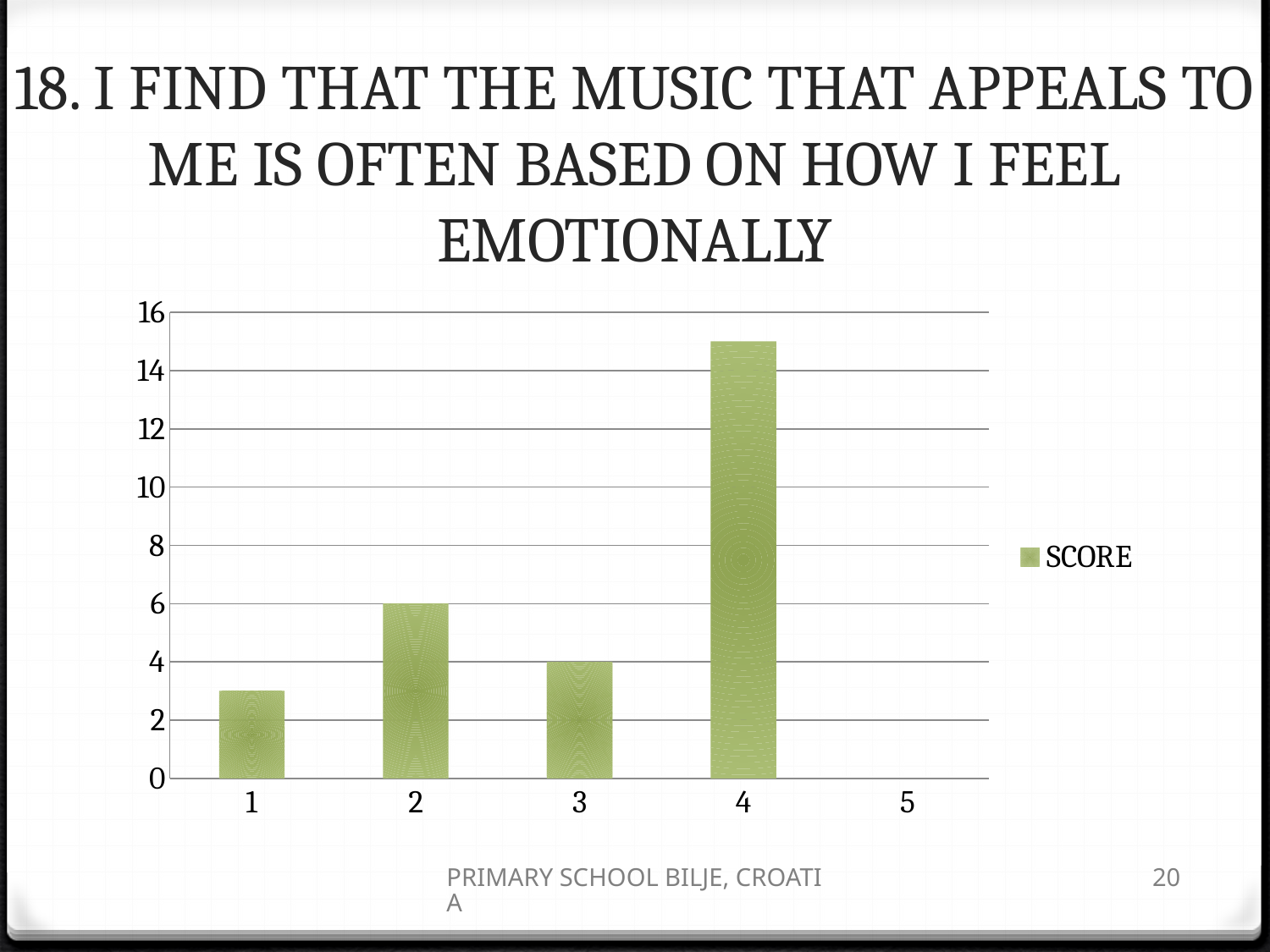
Is the SCORE value for category 4 greater or less than 14? greater What is the SCORE value for category 3? 4 Which category has the lowest SCORE? 5 Is the SCORE value for category 1 greater or less than 4? less Which has a larger SCORE, category 1 or category 4? 4 What is the SCORE value for category 5? 0 How many categories are shown on the x axis? 5 What is the SCORE value for category 2? 6 What is the difference between the SCORE values for category 2 and category 3? 2 Which category has the highest SCORE? 4 How many series does the legend list? 1 What type of chart is shown on the slide? bar chart